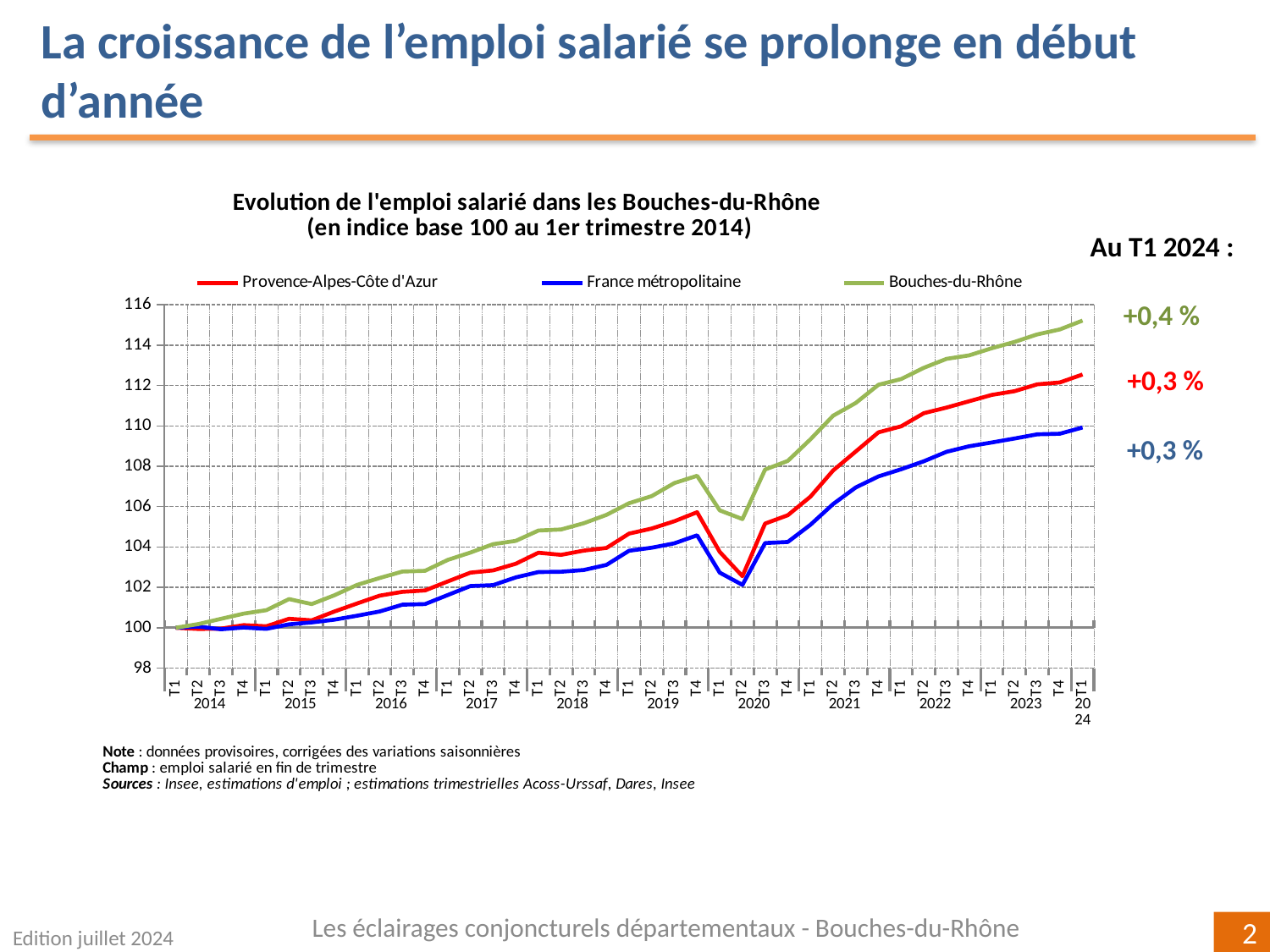
Is the value for Provence-Alpes-Côte d'Azur at T4 2019 greater or less than 104? greater At T1 2024, which is higher: Provence-Alpes-Côte d'Azur or France métropolitaine? Provence-Alpes-Côte d'Azur What is the title of the chart? Evolution de l'emploi salarié dans les Bouches-du-Rhône (en indice base 100 au 1er trimestre 2014) In which quarter do all three series reach their lowest point after 2019? T2 2020 Is the value for France métropolitaine at T2 2020 greater or less than 104? less Is the value for Bouches-du-Rhône at T1 2024 greater or less than 114? greater What kind of chart is shown on the slide? line chart What growth rate is annotated for Bouches-du-Rhône at T1 2024? +0,4 % Overall, do the three series rise or fall from T1 2014 to T1 2024? rise Which three series are listed in the chart legend? Provence-Alpes-Côte d'Azur, France métropolitaine, Bouches-du-Rhône Which series has the highest value at T1 2024? Bouches-du-Rhône How many series does the legend list? 3